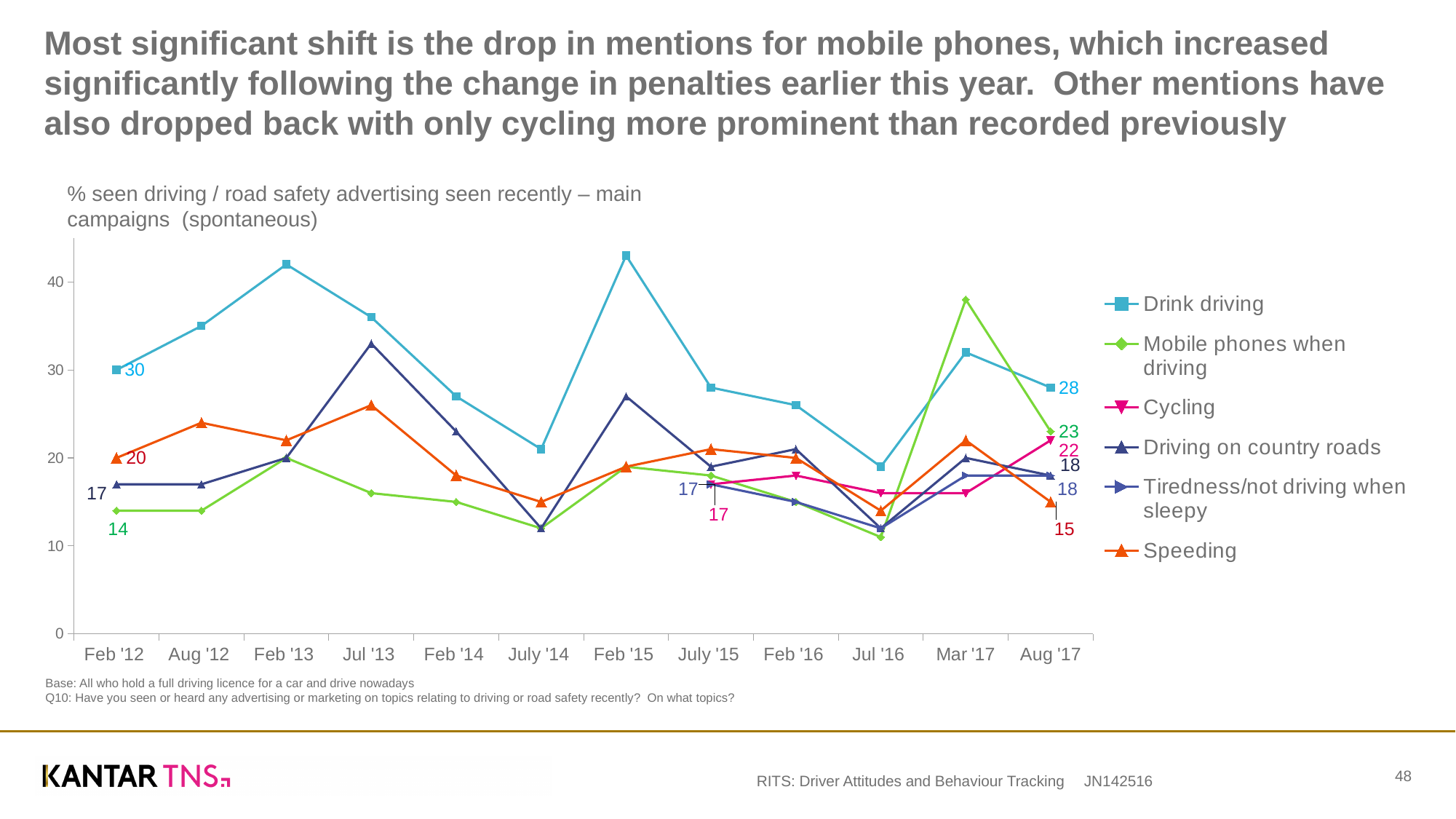
What is the value for Mobile phones when driving in Aug '17? 23 What is the value for Cycling in July '15? 17 Which series has the lowest value in Aug '17? Speeding What is the value for Speeding in Aug '17? 15 By how much did Mobile phones when driving rise from Feb '12 to Aug '17? 9 How many time points are shown on the x axis? 12 By how much did Drink driving fall from Feb '12 to Aug '17? 2 Which series has the highest value in Aug '17? Drink driving In Aug '17, which is larger: Cycling or Speeding? Cycling What is the value for Drink driving in Feb '12? 30 How many series does the legend list? 6 Is the value for Drink driving in Feb '15 greater or less than 40? greater